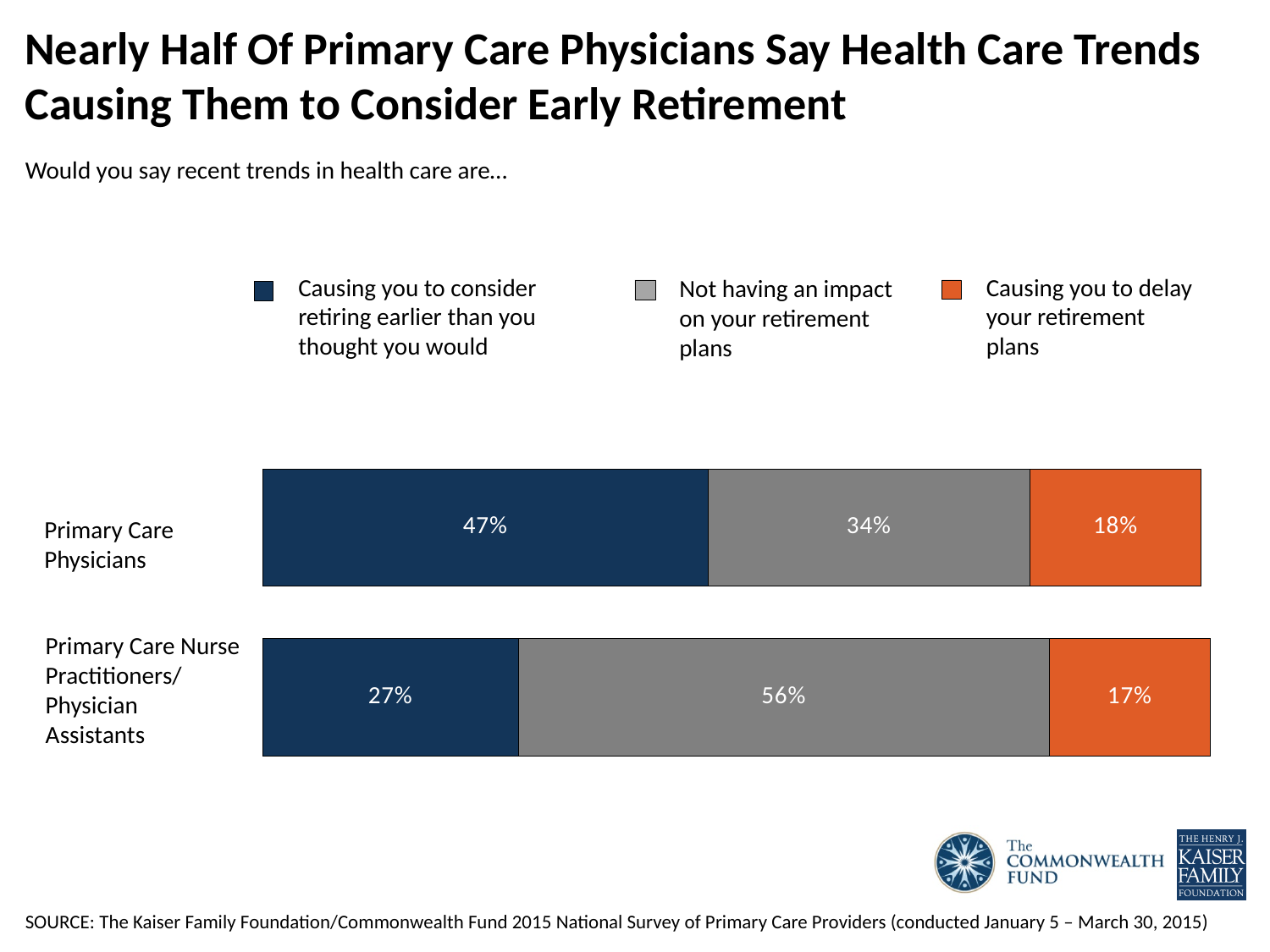
What percentage of Primary Care Nurse Practitioners/Physician Assistants say recent trends are causing them to consider retiring earlier than they thought they would? 27% What percentage of Primary Care Physicians say recent trends are causing them to delay their retirement plans? 18% What percentage of Primary Care Nurse Practitioners/Physician Assistants say recent trends are not having an impact on their retirement plans? 56% Which response is the largest for Primary Care Nurse Practitioners/Physician Assistants? Not having an impact on your retirement plans Which response is the smallest for Primary Care Physicians? Causing you to delay your retirement plans Which group has the higher share saying trends are causing them to consider retiring earlier: Primary Care Physicians or Primary Care Nurse Practitioners/Physician Assistants? Primary Care Physicians What is the difference in percentage points between the 'Not having an impact' shares for Primary Care Nurse Practitioners/Physician Assistants and Primary Care Physicians? 22 percentage points What percentage of Primary Care Physicians say recent trends are causing them to consider retiring earlier than they thought they would? 47% What kind of chart is shown on the slide? Stacked bar chart How many series does the legend list? 3 How many groups of providers are shown in the chart? 2 What is the difference in percentage points between Primary Care Physicians and Primary Care Nurse Practitioners/Physician Assistants who say trends are causing them to consider retiring earlier? 20 percentage points